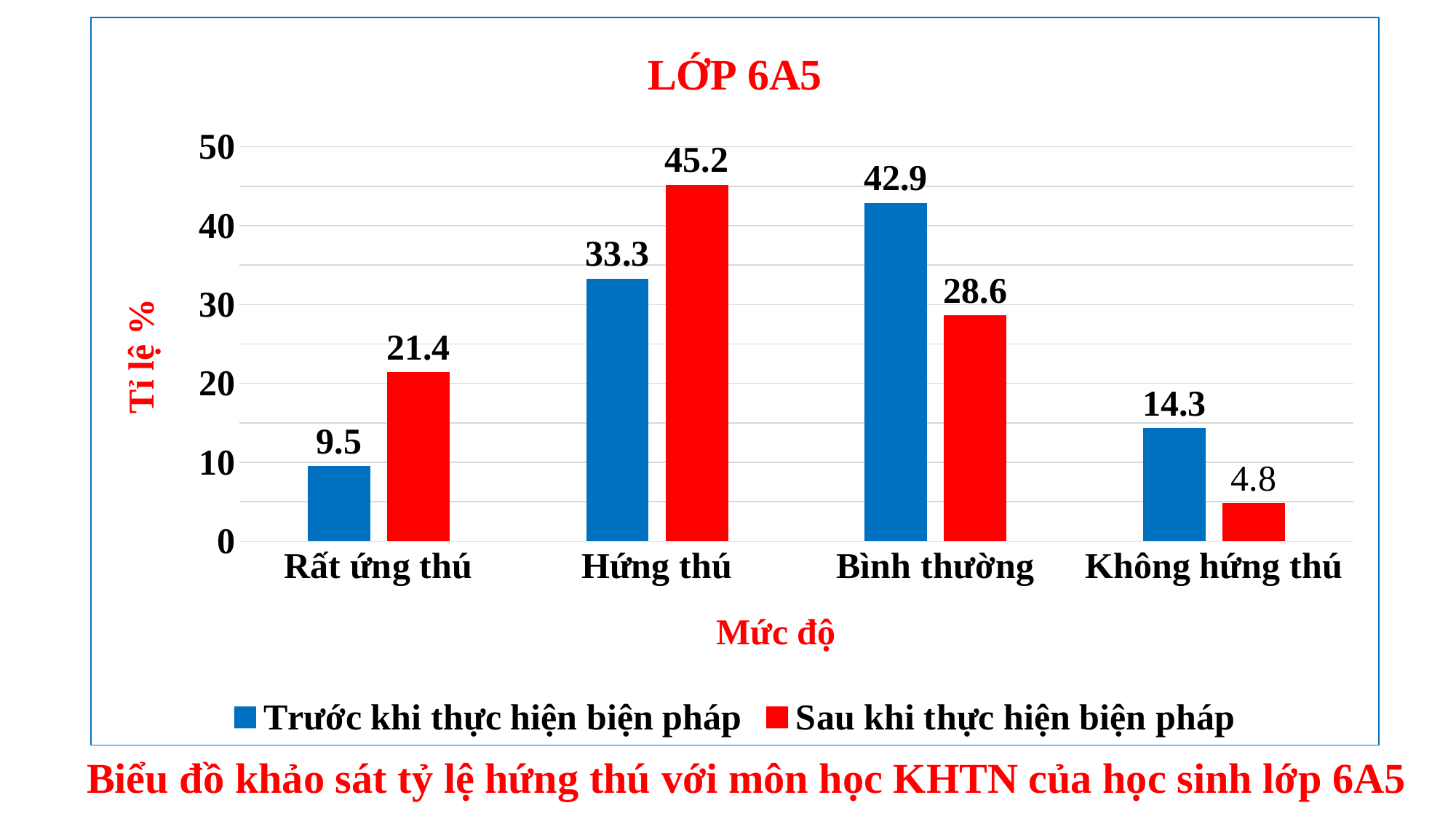
How many series does the legend list? 2 What is the difference between the "Sau khi thực hiện biện pháp" and "Trước khi thực hiện biện pháp" values for "Rất ứng thú"? 11.9 Is the value for "Hứng thú" in the "Trước khi thực hiện biện pháp" series greater or less than 30? greater Which category has the lowest value in the "Sau khi thực hiện biện pháp" series? Không hứng thú What kind of chart is shown on the slide? Bar chart What is the value for "Không hứng thú" in the "Sau khi thực hiện biện pháp" series? 4.8 What is the value for "Rất ứng thú" in the "Trước khi thực hiện biện pháp" series? 9.5 What is the value for "Hứng thú" in the "Sau khi thực hiện biện pháp" series? 45.2 How many categories are shown on the x axis? 4 For "Bình thường", which series has the larger value? Trước khi thực hiện biện pháp What is the title of the chart? LỚP 6A5 Which category has the highest value in the "Trước khi thực hiện biện pháp" series? Bình thường